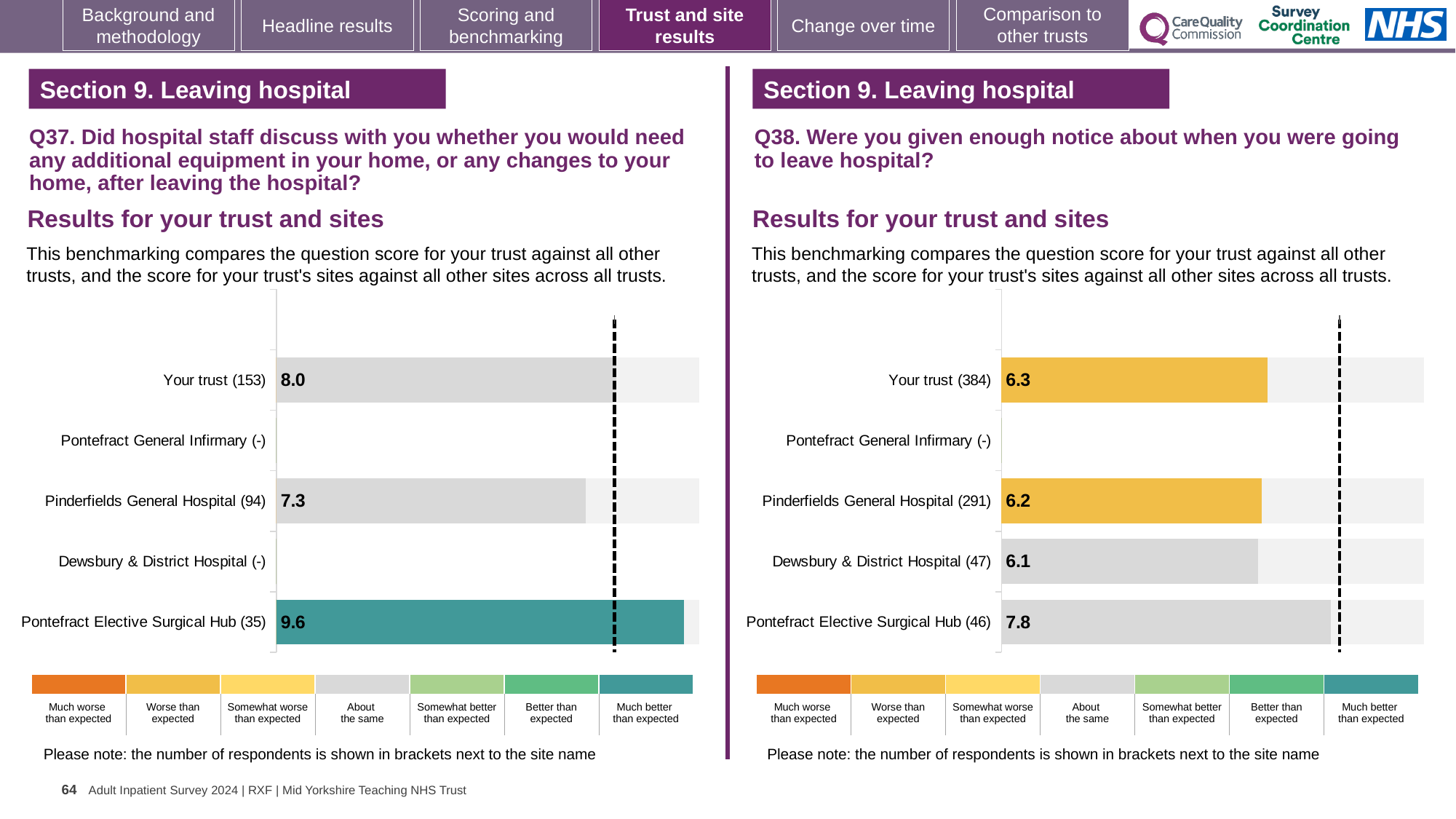
In the Q38 chart on the right, what is the score for Your trust (384)? 6.3 In the Q37 chart on the left, which site has the highest score? Pontefract Elective Surgical Hub (35) In the Q38 chart on the right, which is larger: the score for Pontefract Elective Surgical Hub (46) or Your trust (384)? Pontefract Elective Surgical Hub (46) In the Q38 chart on the right, what is the difference between the scores for Pontefract Elective Surgical Hub (46) and Pinderfields General Hospital (291)? 1.6 What type of chart is used on the left for Q37? Bar chart In the Q37 chart on the left, what is the difference between the scores for Pontefract Elective Surgical Hub (35) and Your trust (153)? 1.6 In the Q37 chart on the left, what is the score for Pinderfields General Hospital (94)? 7.3 In the Q37 chart on the left, what is the score for Your trust (153)? 8.0 In the Q37 chart on the left, which benchmark category does the colour of the Pontefract Elective Surgical Hub (35) bar correspond to? Much better than expected In the Q37 chart on the left, how many rows have a score bar plotted? 3 In the Q38 chart on the right, which site has the lowest score among those with a bar? Dewsbury & District Hospital (47) In the Q38 chart on the right, what is the score for Dewsbury & District Hospital (47)? 6.1